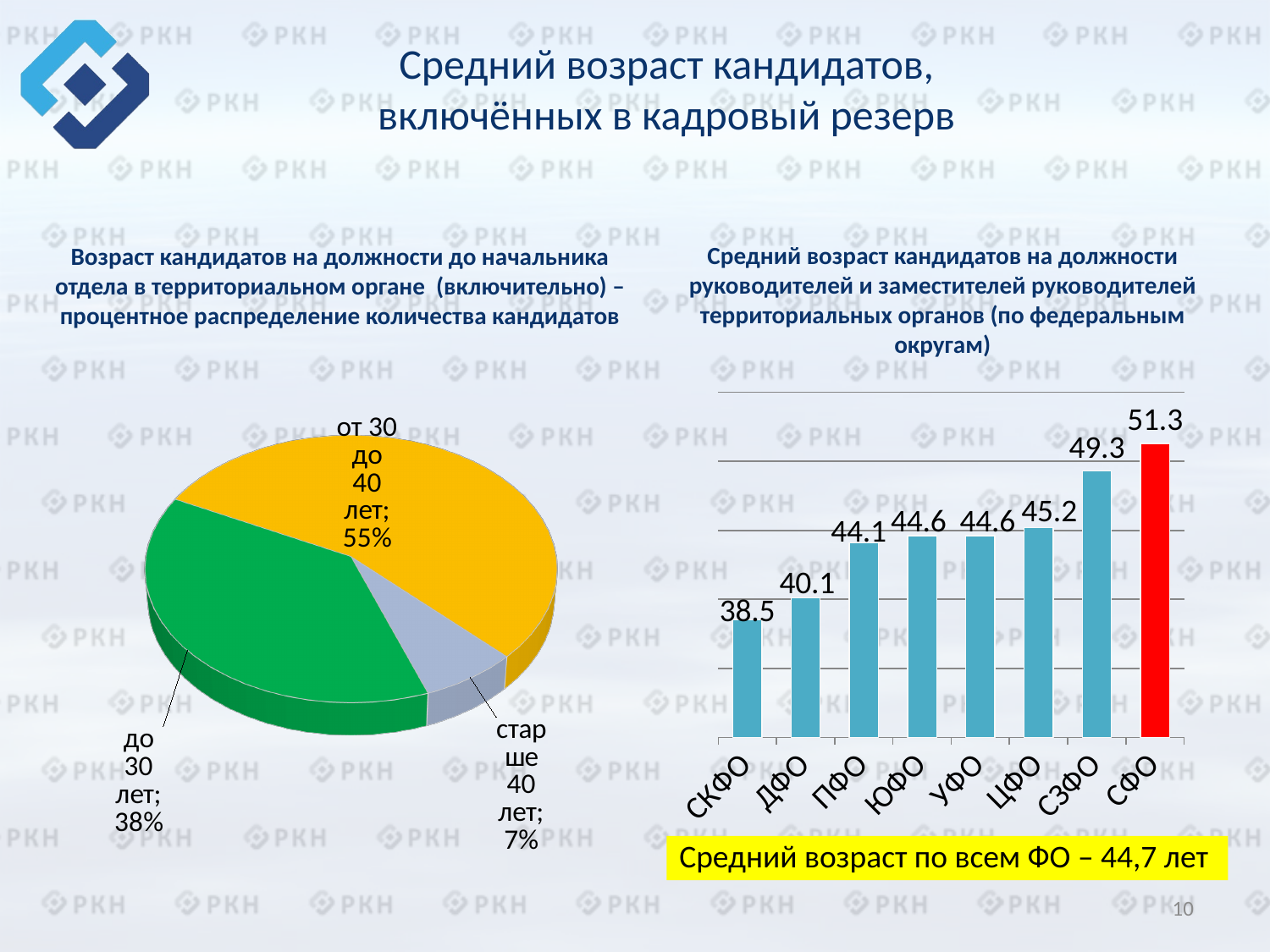
In the pie chart on the left, which age group has the smallest share? старше 40 лет In the pie chart on the left, what share of candidates are aged from 30 to 40 (от 30 до 40 лет)? 55% In the bar chart on the right, which bar is coloured red rather than blue? СФО In the pie chart on the left, what share of candidates are under 30 (до 30 лет)? 38% In the bar chart on the right, what is the average age for СКФО? 38.5 In the bar chart on the right, what is the difference between the values for СФО and СКФО? 12.8 In the pie chart on the left, by how many percentage points does the 'от 30 до 40 лет' share exceed the 'до 30 лет' share? 17 In the bar chart on the right, which federal district has the lowest average age? СКФО In the pie chart on the left, how many slices are there? 3 In the bar chart on the right, which federal district has the highest average age? СФО In the bar chart on the right, how many federal districts are shown? 8 In the bar chart on the right, what is the average age for СЗФО? 49.3